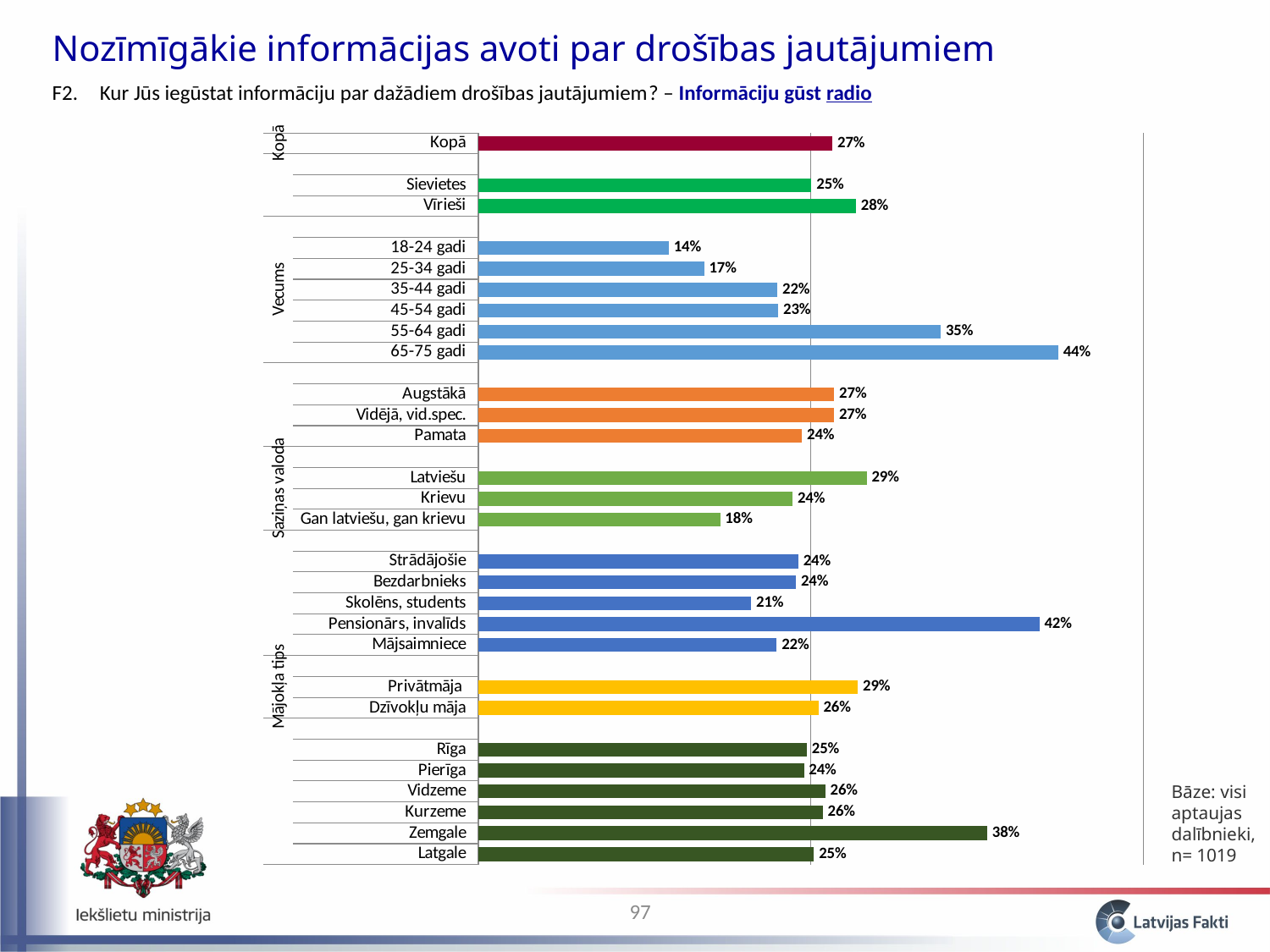
What is the difference between the values for Zemgale and Latgale? 13% What is the value for Zemgale? 38% What is the value for 65-75 gadi? 44% Do the values rise or fall as age increases from 18-24 gadi to 65-75 gadi? rise What is the value for Pensionārs, invalīds? 42% Which category has the lowest value in the chart? 18-24 gadi What is the difference between the values for Vīrieši and Sievietes? 3% Which category has the highest value in the chart? 65-75 gadi What kind of chart is shown on the slide? bar chart What is the value for Kopā? 27% How many bars are plotted in the chart? 28 Which is larger, the value for Latviešu or the value for Krievu? Latviešu